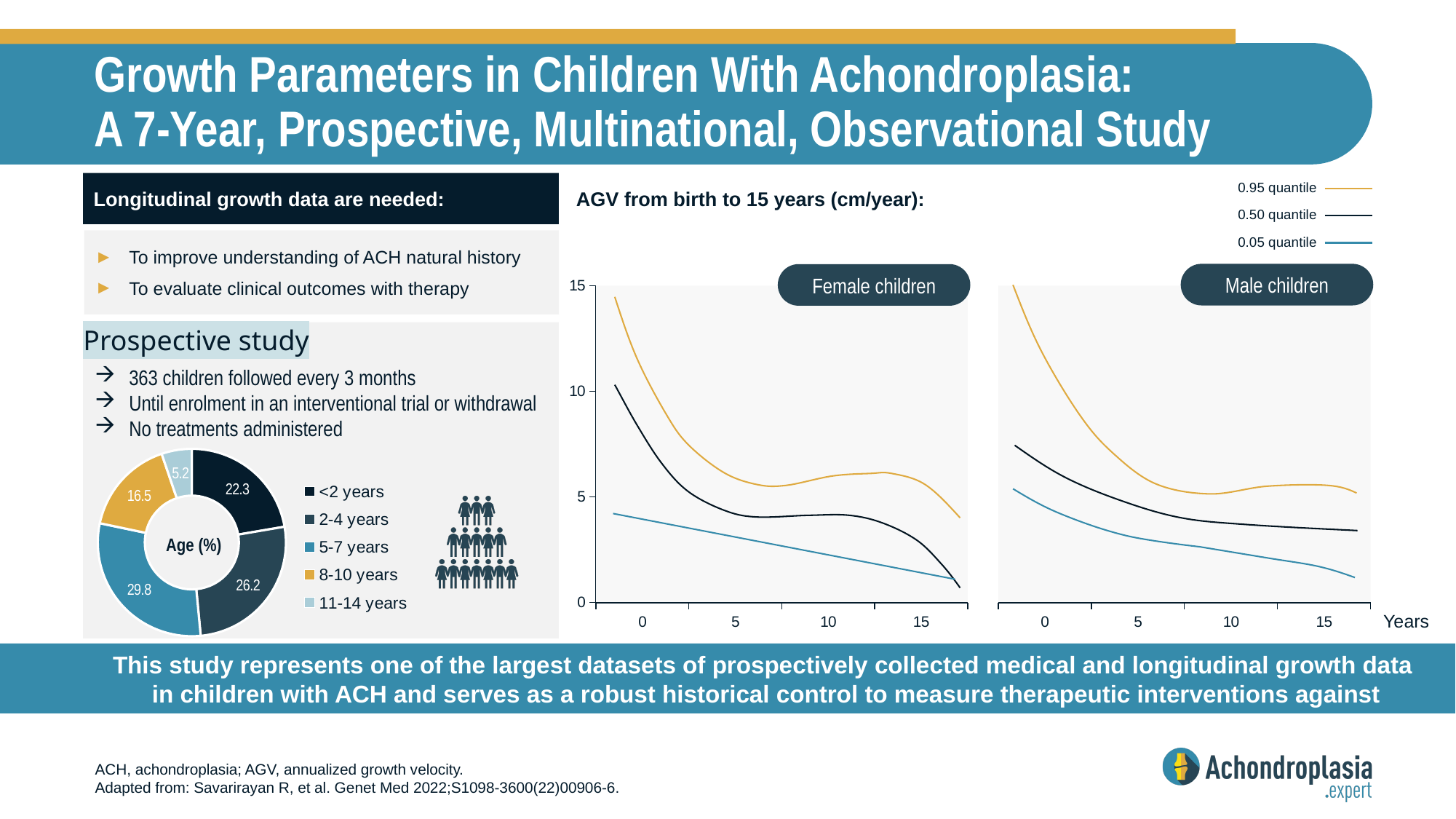
In the Age (%) donut chart, what is the value for the 5-7 years category? 29.8 In the AGV charts, which colour represents the 0.95 quantile? Gold/orange In the Age (%) donut chart, which is larger: the 8-10 years value or the <2 years value? <2 years In the Age (%) donut chart, what is the difference between the 2-4 years and <2 years values? 3.9 In the Age (%) donut chart, what is the value for the 11-14 years category? 5.2 In the Female children AGV chart, is the 0.95 quantile value at age 0 greater or less than 10? greater What kind of chart is the Age (%) chart? Donut (pie) chart How many quantile series does the legend for the AGV charts list? 3 In the Age (%) donut chart, which age category has the smallest share? 11-14 years In the Age (%) donut chart, which age category has the largest share? 5-7 years In the Male children AGV chart, does the 0.05 quantile line rise or fall from age 0 to age 15? fall How many age categories does the Age (%) donut chart show? 5